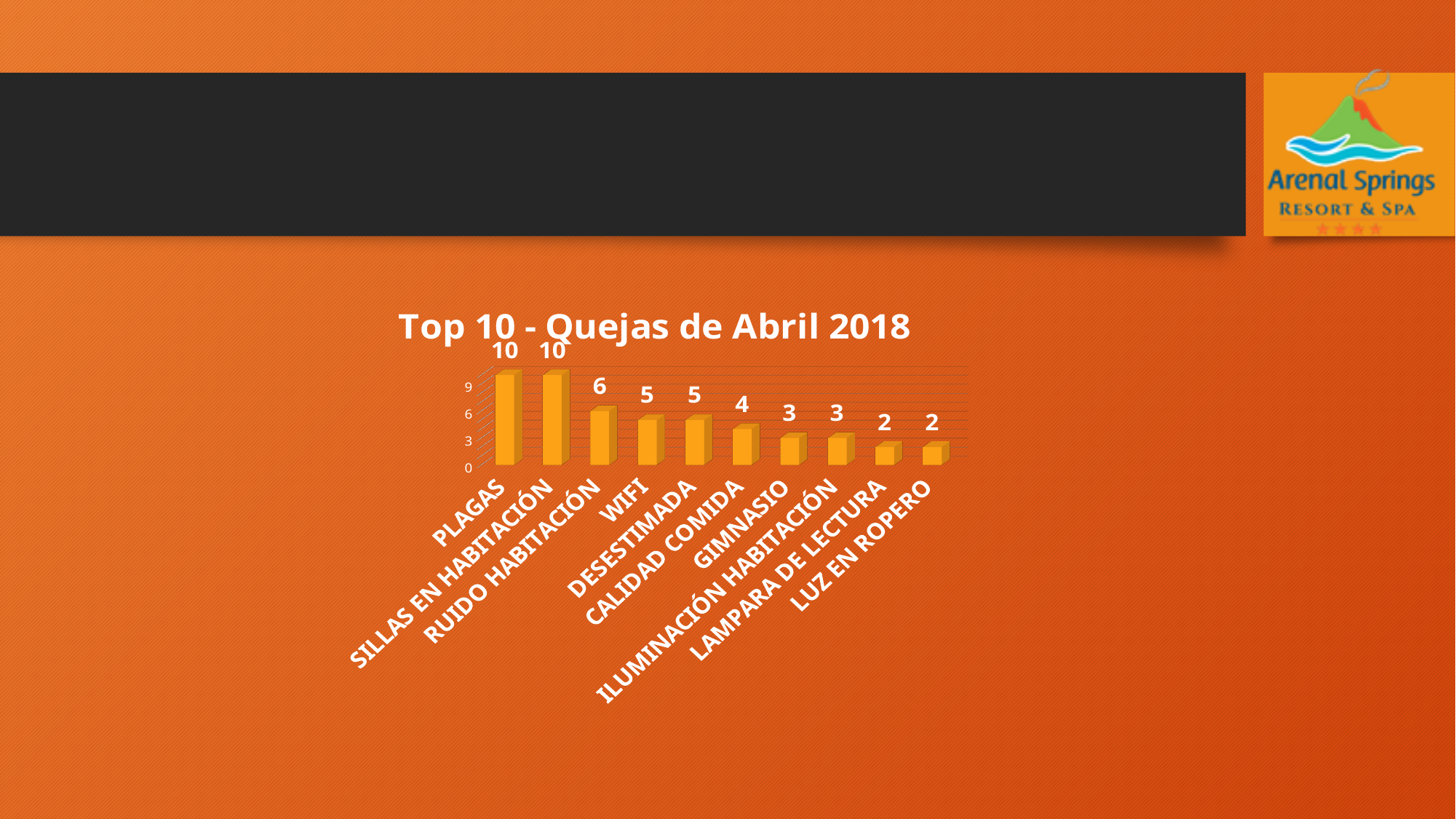
What is the value for CALIDAD COMIDA? 4 What is the title of the chart? Top 10 - Quejas de Abril 2018 Do the values rise or fall from left to right along the x axis? fall What is the value for WIFI? 5 How many categories are plotted in the chart? 10 What is the value for GIMNASIO? 3 Which is larger, the value for WIFI or the value for GIMNASIO? WIFI What type of chart is shown on the slide? bar chart What is the difference between the values for PLAGAS and RUIDO HABITACIÓN? 4 What is the value for PLAGAS? 10 What is the value for LUZ EN ROPERO? 2 What is the value for RUIDO HABITACIÓN? 6